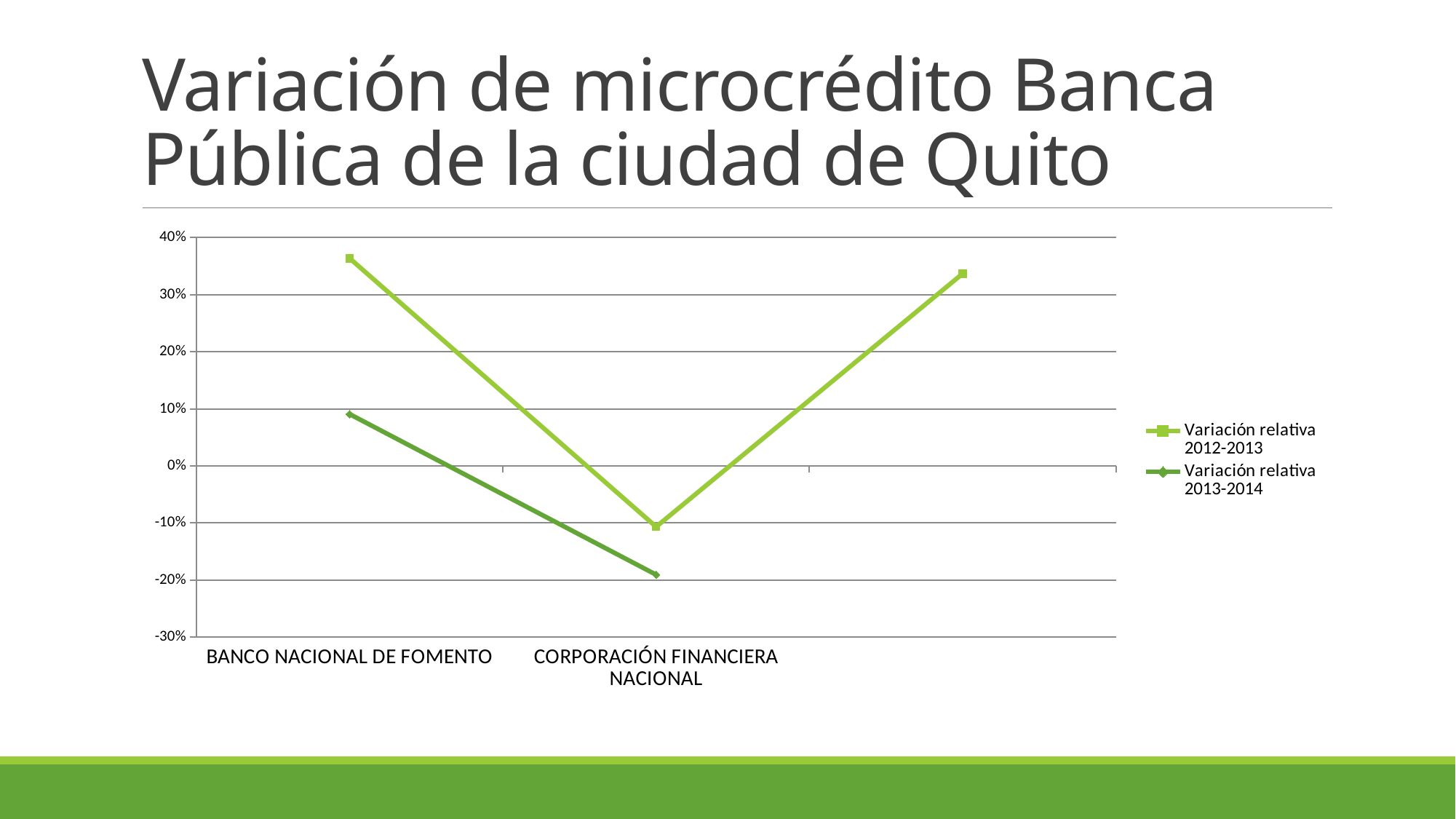
What are the two series named in the legend? Variación relativa 2012-2013 and Variación relativa 2013-2014 Which labeled category has the lowest value in the Variación relativa 2012-2013 series? CORPORACIÓN FINANCIERA NACIONAL For CORPORACIÓN FINANCIERA NACIONAL, which series has the larger value: Variación relativa 2012-2013 or Variación relativa 2013-2014? Variación relativa 2012-2013 Is the value for BANCO NACIONAL DE FOMENTO in the Variación relativa 2013-2014 series greater or less than 0%? greater Does the Variación relativa 2013-2014 series rise or fall from BANCO NACIONAL DE FOMENTO to CORPORACIÓN FINANCIERA NACIONAL? fall For BANCO NACIONAL DE FOMENTO, which series has the larger value: Variación relativa 2012-2013 or Variación relativa 2013-2014? Variación relativa 2012-2013 What is the title of the slide containing the chart? Variación de microcrédito Banca Pública de la ciudad de Quito How many series does the legend list? 2 Is the value for CORPORACIÓN FINANCIERA NACIONAL in the Variación relativa 2013-2014 series greater or less than -10%? less What kind of chart is shown on the slide? line chart Is the value for BANCO NACIONAL DE FOMENTO in the Variación relativa 2012-2013 series greater or less than 30%? greater